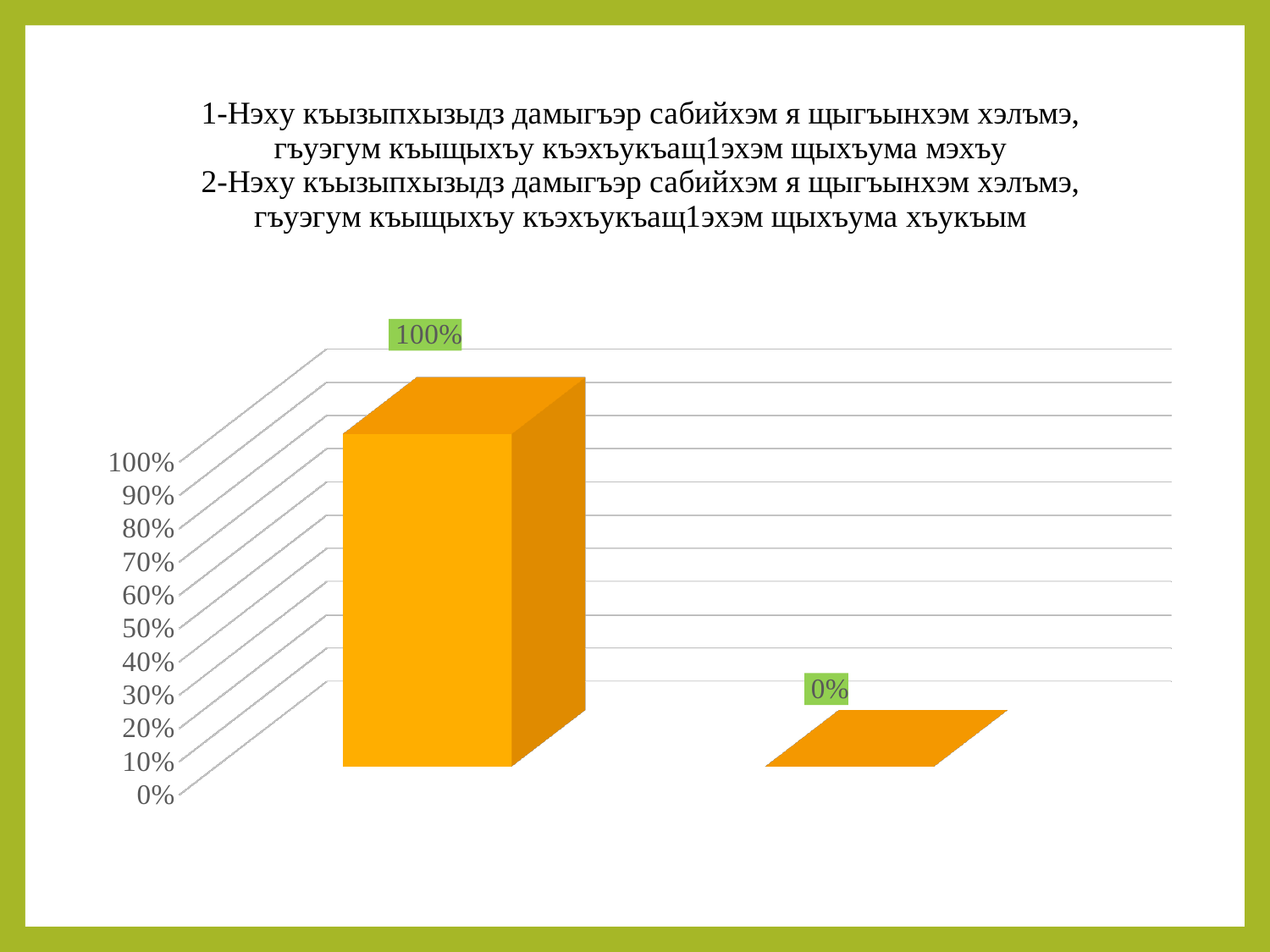
How many bars are plotted in the chart? 2 What value is shown on the data label of the left bar? 100% What colour are the bars in the chart? orange Is the value of the left bar greater or less than 50%? greater What kind of chart is shown on the slide? bar chart Which bar is the lowest, the left one or the right one? the right one Is the value of the right bar greater or less than 10%? less What value is shown on the data label of the right bar? 0% What is the difference between the values of the left bar and the right bar? 100% Which bar is the highest, the left one or the right one? the left one Which is larger, the value of the left bar or the value of the right bar? the left bar What is the highest tick value shown on the vertical axis? 100%